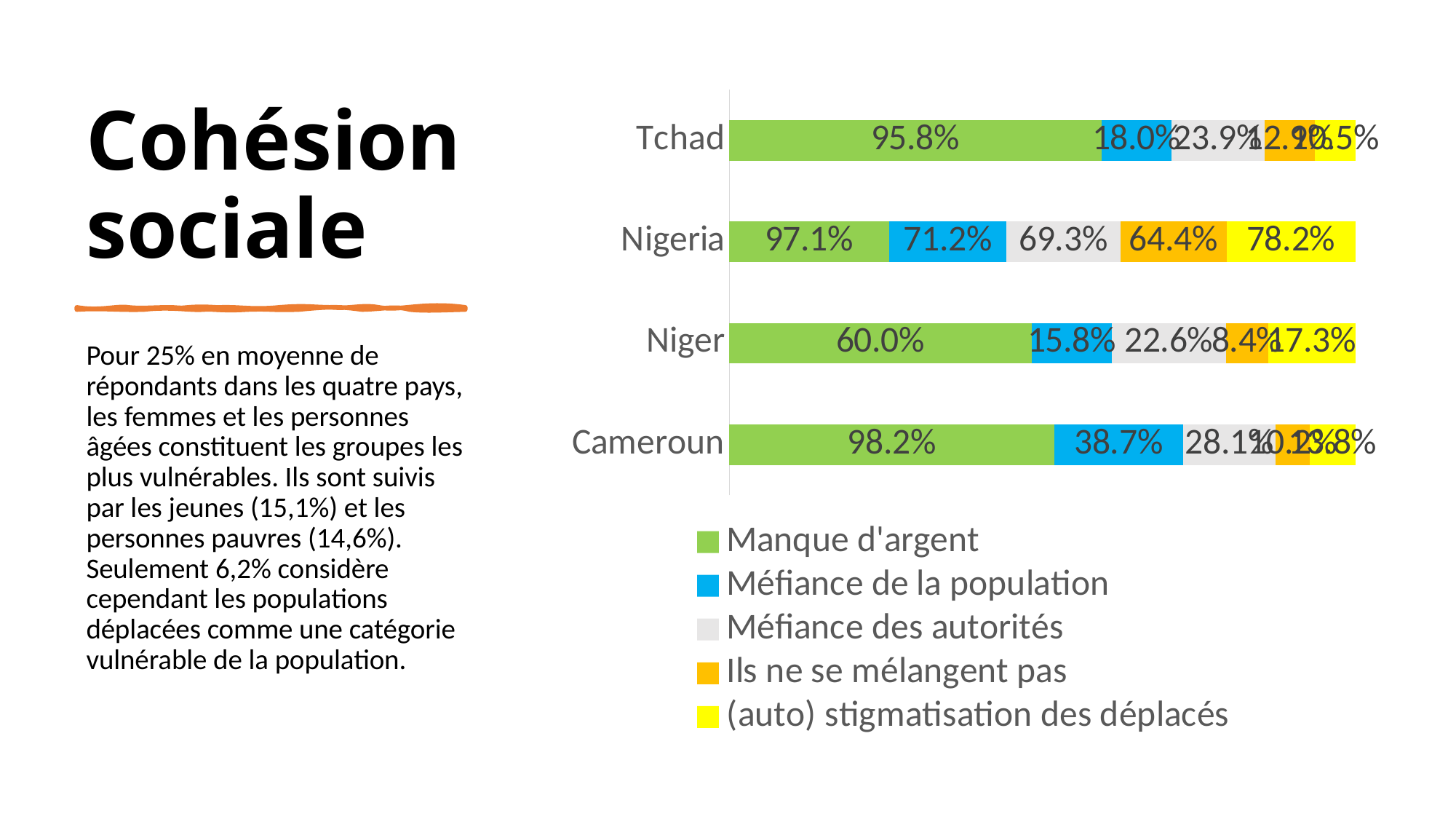
What is the difference between the "Manque d'argent" values for Cameroun and Niger? 38.2% Which country has the highest value for "Méfiance de la population"? Nigeria What is the value of "(auto) stigmatisation des déplacés" for Nigeria? 78.2% Which country has the lowest value for "Manque d'argent"? Niger What is the value of "Manque d'argent" for Nigeria? 97.1% How many series does the legend list? 5 What type of chart is shown on the slide? stacked bar chart What is the value of "Méfiance de la population" for Cameroun? 38.7% What is the value of "Méfiance de la population" for Nigeria? 71.2% Which is larger: "Méfiance des autorités" for Nigeria or for Niger? Nigeria How many countries are shown on the chart? 4 What is the value of "Manque d'argent" for Niger? 60.0%